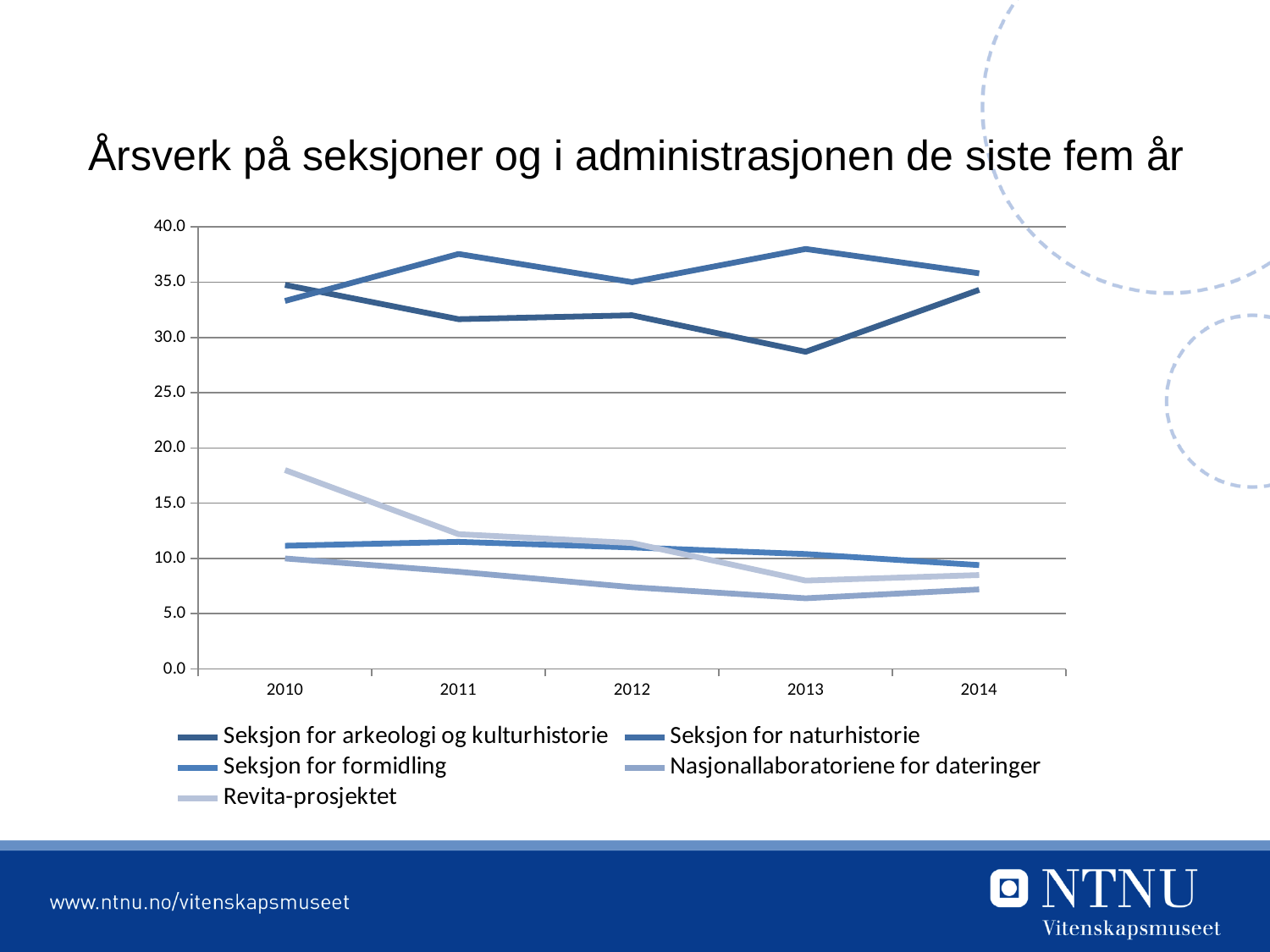
What is the title of the chart? Årsverk på seksjoner og i administrasjonen de siste fem år Is the value for Revita-prosjektet in 2010 greater or less than 15.0? greater How many years are shown on the x axis? 5 Is the value for Nasjonallaboratoriene for dateringer in 2013 greater or less than 10.0? less Which series has the lowest value in 2013? Nasjonallaboratoriene for dateringer How many series does the legend list? 5 Is the value for Seksjon for naturhistorie in 2013 greater or less than 35.0? greater Do the values for Nasjonallaboratoriene for dateringer rise or fall from 2010 to 2013? fall Do the values for Revita-prosjektet rise or fall from 2010 to 2013? fall In 2010, which is larger: Revita-prosjektet or Seksjon for formidling? Revita-prosjektet What kind of chart is shown on the slide? line chart